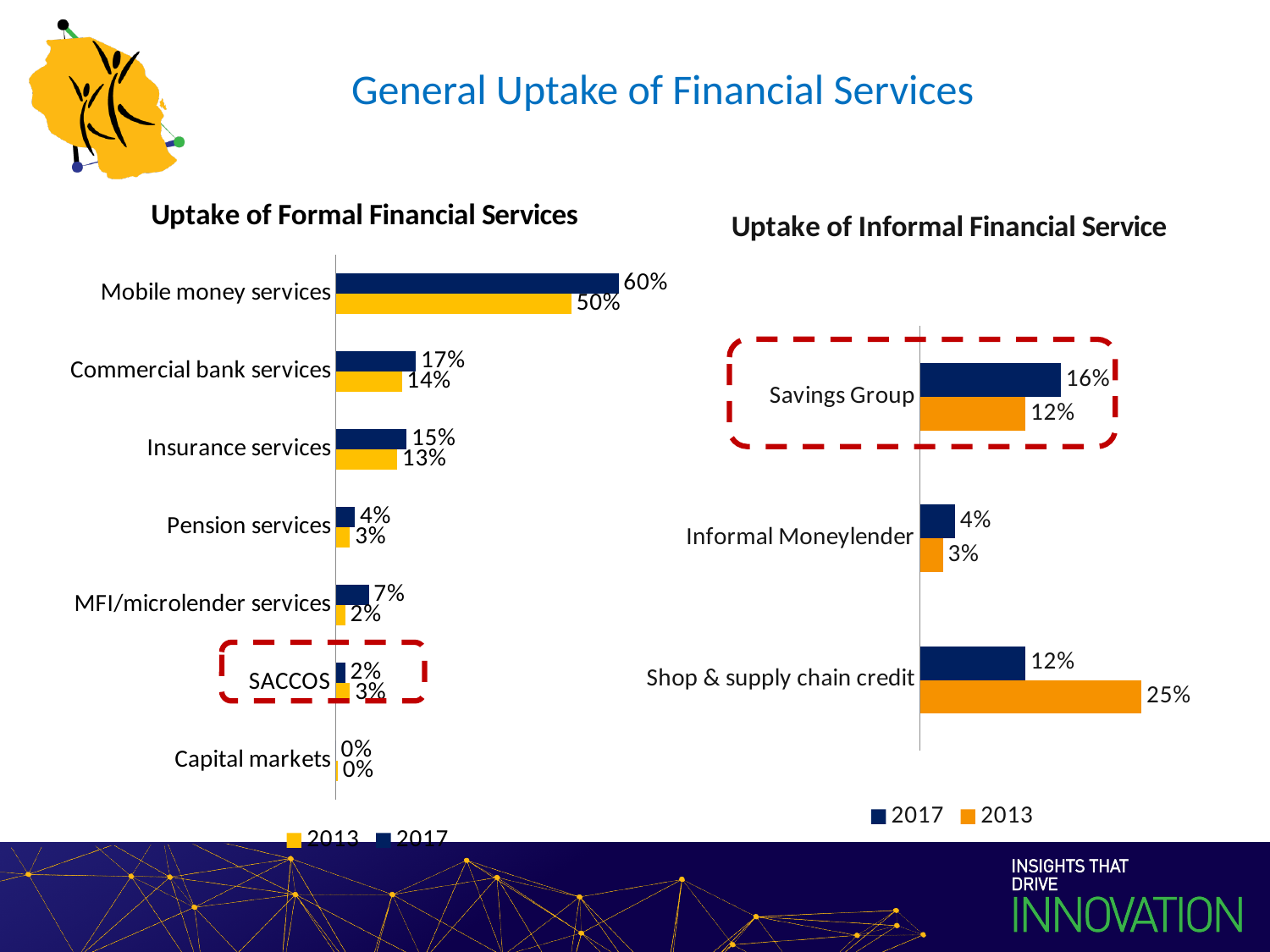
In the 'Uptake of Formal Financial Services' chart, what is the 2017 value for Mobile money services? 60% In the 'Uptake of Informal Financial Service' chart, how many series does the legend list? 2 In the 'Uptake of Informal Financial Service' chart, what is the 2017 value for Savings Group? 16% In the 'Uptake of Informal Financial Service' chart, what is the 2013 value for Shop & supply chain credit? 25% In the 'Uptake of Formal Financial Services' chart, which category has the lowest 2017 value? Capital markets In the 'Uptake of Formal Financial Services' chart, which is larger for SACCOS: the 2013 value or the 2017 value? 2013 In the 'Uptake of Formal Financial Services' chart, which category has the highest 2017 value? Mobile money services In the 'Uptake of Formal Financial Services' chart, what is the 2013 value for Commercial bank services? 14% What type of chart is the 'Uptake of Informal Financial Service' chart? Bar chart In the 'Uptake of Formal Financial Services' chart, what is the difference between the 2017 and 2013 values for Mobile money services? 10% In the 'Uptake of Informal Financial Service' chart, what is the difference between the 2013 and 2017 values for Shop & supply chain credit? 13% In the 'Uptake of Formal Financial Services' chart, how many categories are shown? 7